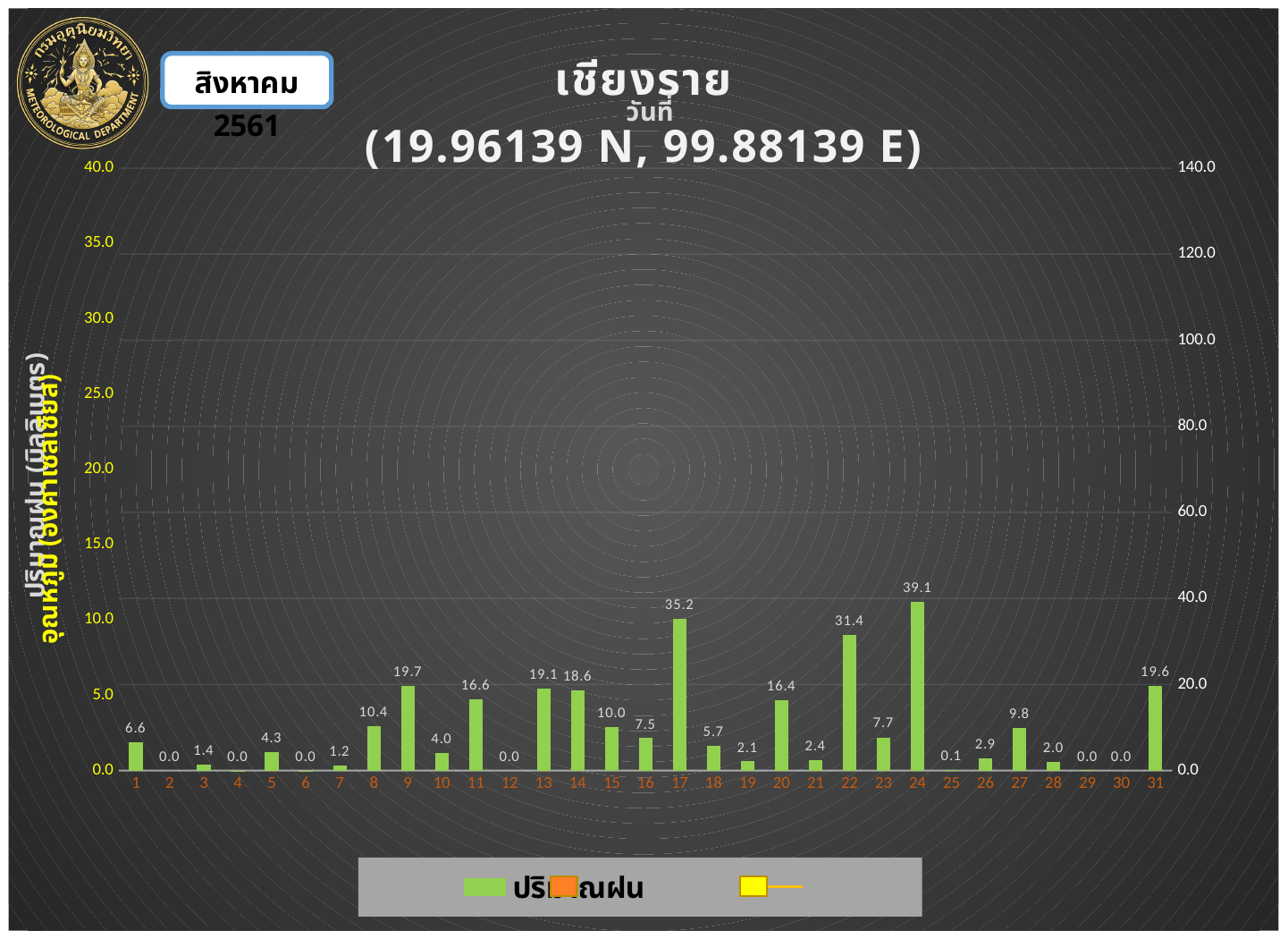
What is the difference between the rainfall values for day 24 and day 17? 3.9 Which day has the larger rainfall value, day 11 or day 20? 11 What kind of chart is shown on the slide? bar chart Which day has the larger rainfall value, day 13 or day 14? 13 What is the rainfall value shown for day 9? 19.7 What is the rainfall value shown for day 31? 19.6 What is the difference between the rainfall values for day 22 and day 8? 21.0 How many days are shown on the x axis? 31 What city name is shown in the chart title? เชียงราย Which day has the highest rainfall value? 24 What is the rainfall value shown for day 17? 35.2 What is the rainfall value shown for day 24? 39.1